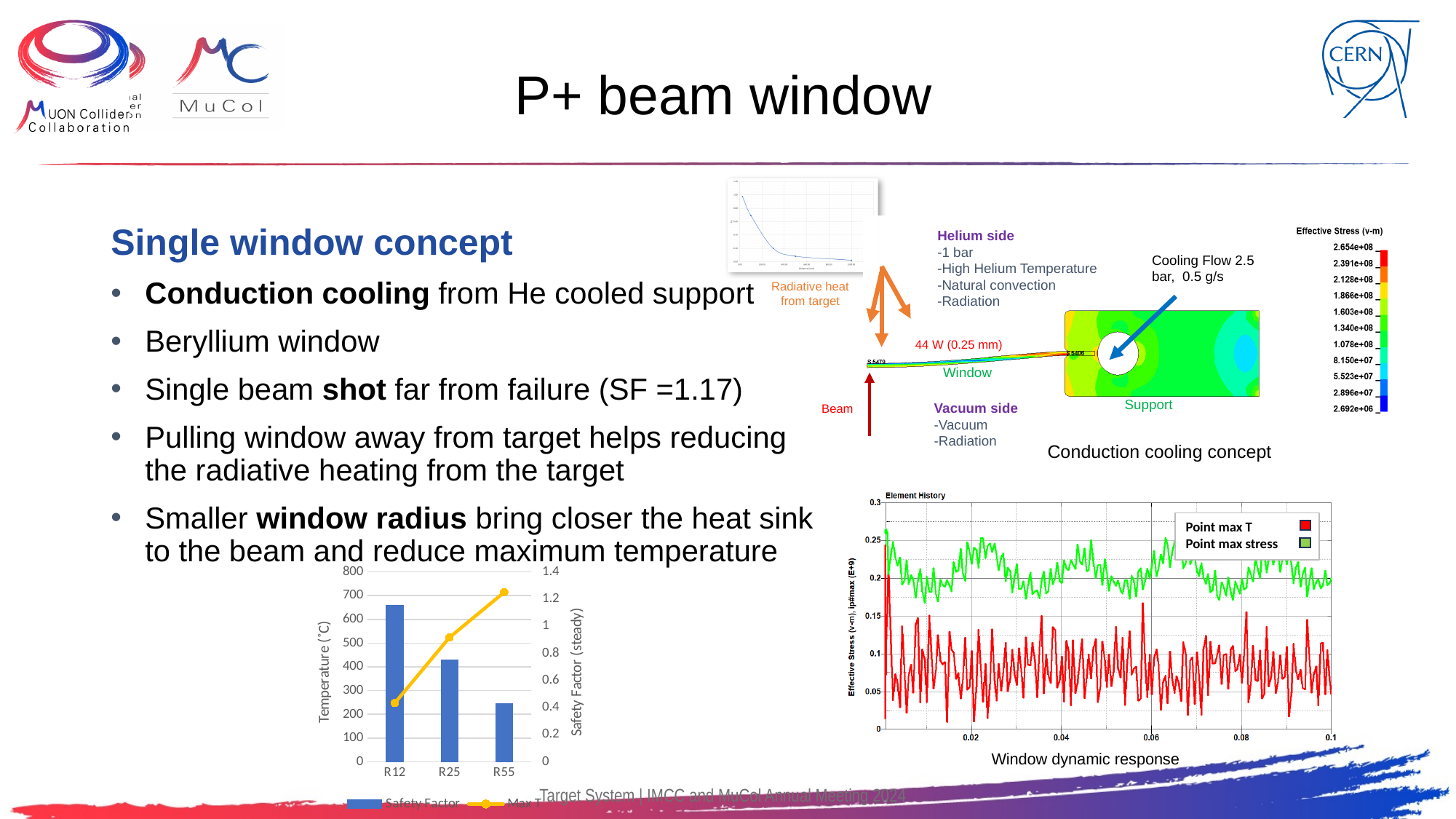
In the Element History chart on the right, which series has the higher values, Point max T or Point max stress? Point max stress In the bottom-left chart, is the orange line point for R55 greater or less than 1 on the right axis? greater In the bottom-left chart, is the bar for R12 greater or less than 600 on the left axis? greater What kind of chart is the bottom-left chart with categories R12, R25 and R55? A bar chart combined with a line chart In the Element History chart on the right, how many series does the legend list? 2 In the bottom-left chart, which category has the shortest bar? R55 In the bottom-left chart, do the bar values rise or fall from R12 to R55? fall In the bottom-left chart, is the bar for R55 greater or less than 300 on the left axis? less In the bottom-left chart, does the orange line rise or fall from R12 to R55? rise In the bottom-left chart, how many categories are shown on the x axis? 3 In the bottom-left chart, which category has the tallest bar? R12